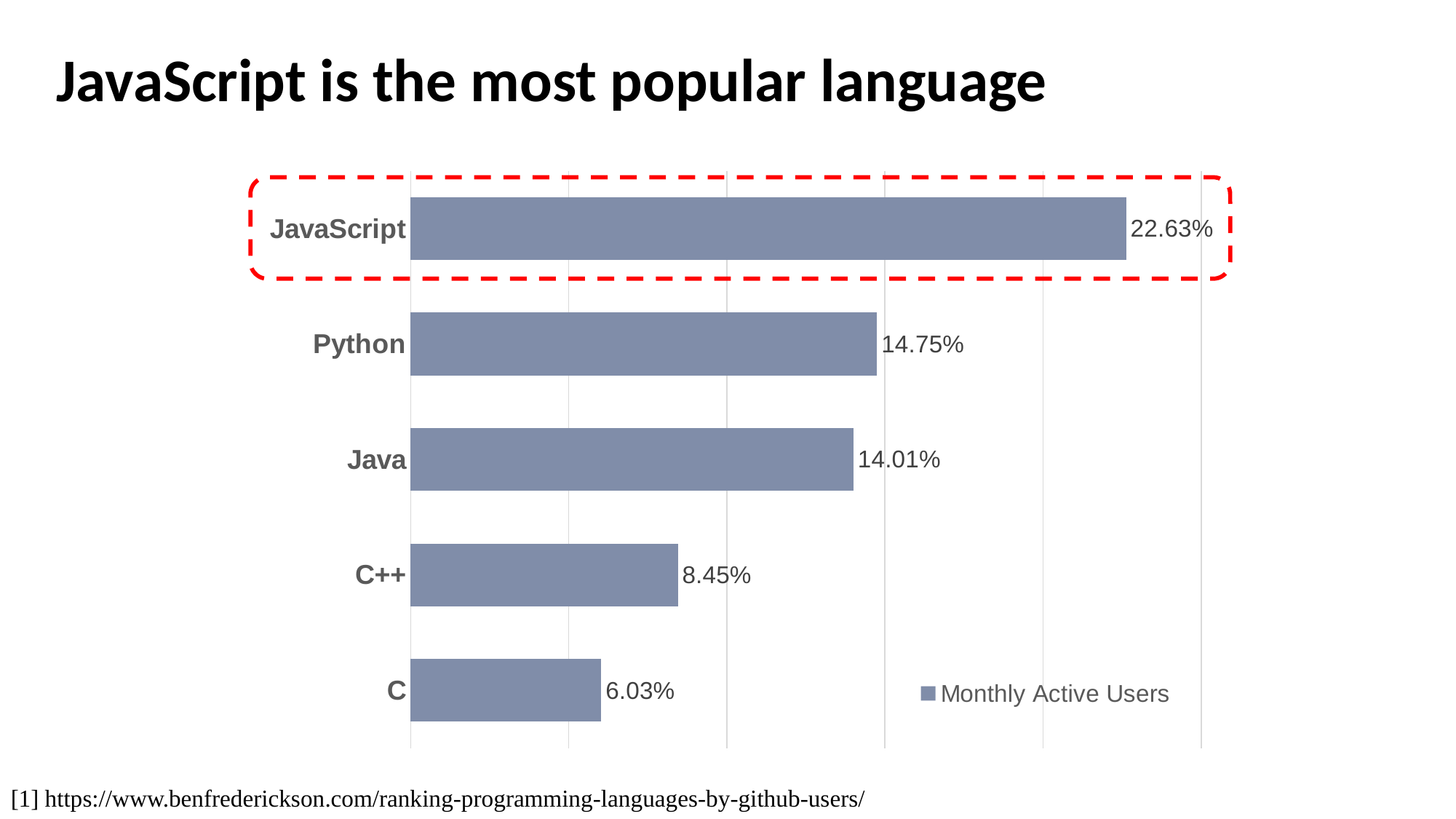
What is the Monthly Active Users value for C? 6.03% What series name does the legend show? Monthly Active Users How many languages are shown in the chart? 5 What kind of chart is shown on the slide? Bar chart Which has a larger value, Java or C++? Java Which language has the highest Monthly Active Users value? JavaScript What is the difference between the values for C++ and C? 2.42% What is the difference between the values for JavaScript and Python? 7.88% What is the Monthly Active Users value for Python? 14.75% Which language has the lowest Monthly Active Users value? C What is the Monthly Active Users value for JavaScript? 22.63% What is the Monthly Active Users value for C++? 8.45%